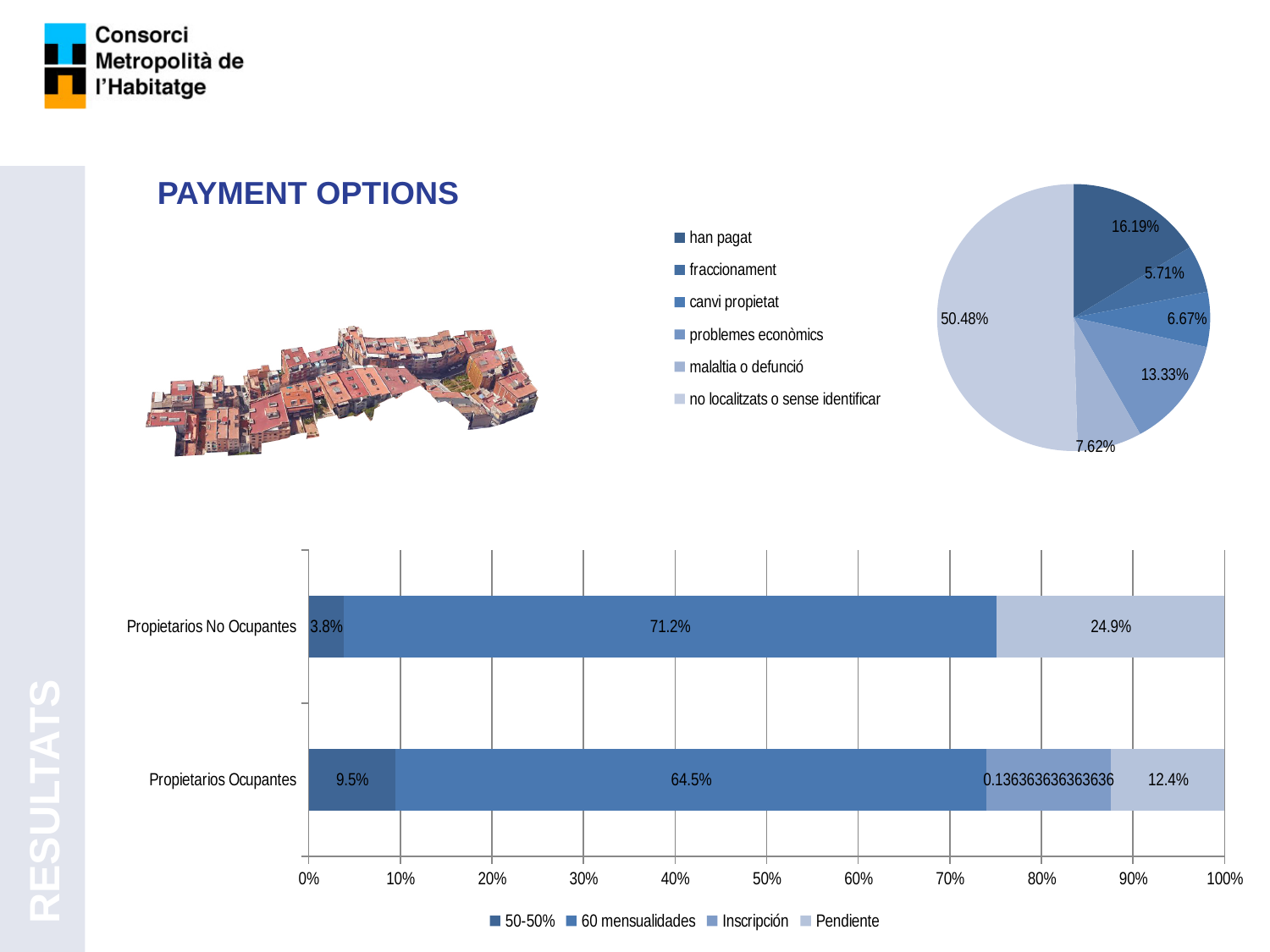
In the pie chart, what is the share for problemes econòmics? 13.33% In the bar chart at the bottom, what is the value of Pendiente for Propietarios Ocupantes? 12.4% In the bar chart at the bottom, what is the value of 50-50% for Propietarios Ocupantes? 9.5% In the pie chart, which category has the smallest slice? fraccionament In the bar chart at the bottom, what is the difference between the Pendiente values for Propietarios No Ocupantes and Propietarios Ocupantes? 12.5% What kind of chart is shown at the bottom of the slide? Stacked bar chart In the pie chart, what is the share for han pagat? 16.19% In the bar chart at the bottom, what is the value of 60 mensualidades for Propietarios No Ocupantes? 71.2% In the bar chart at the bottom, which category has the larger 60 mensualidades value, Propietarios No Ocupantes or Propietarios Ocupantes? Propietarios No Ocupantes In the pie chart, which legend category corresponds to the largest slice? no localitzats o sense identificar In the pie chart, what share is labelled for the largest slice? 50.48% How many categories does the pie chart's legend list? 6